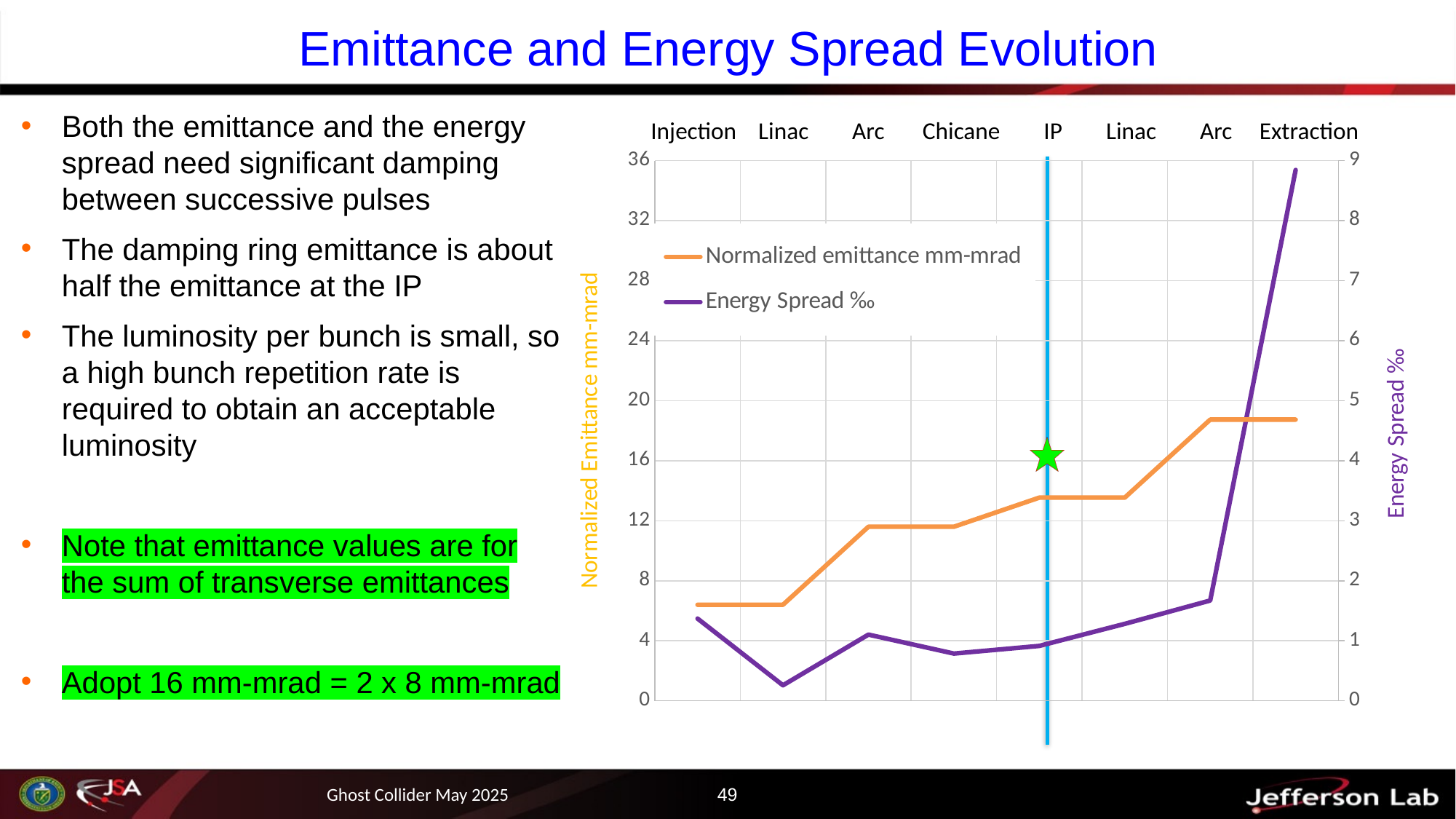
Is the Energy Spread at Extraction greater or less than 8 ‰? greater Does the Normalized emittance generally rise or fall from Injection to Extraction? rise Is the Energy Spread at Chicane greater or less than 2 ‰? less Is the Normalized emittance at Injection greater or less than 8 mm-mrad? less At which stage is the Energy Spread ‰ highest? Extraction How many series does the chart legend list? 2 At which stage is the Energy Spread ‰ lowest? the first Linac How many stages are labelled along the x axis of the chart? 8 What kind of chart is shown on the slide? line chart What colour is the Energy Spread ‰ line in the chart? purple Which is larger, the Normalized emittance at Injection or at the first Arc? the first Arc